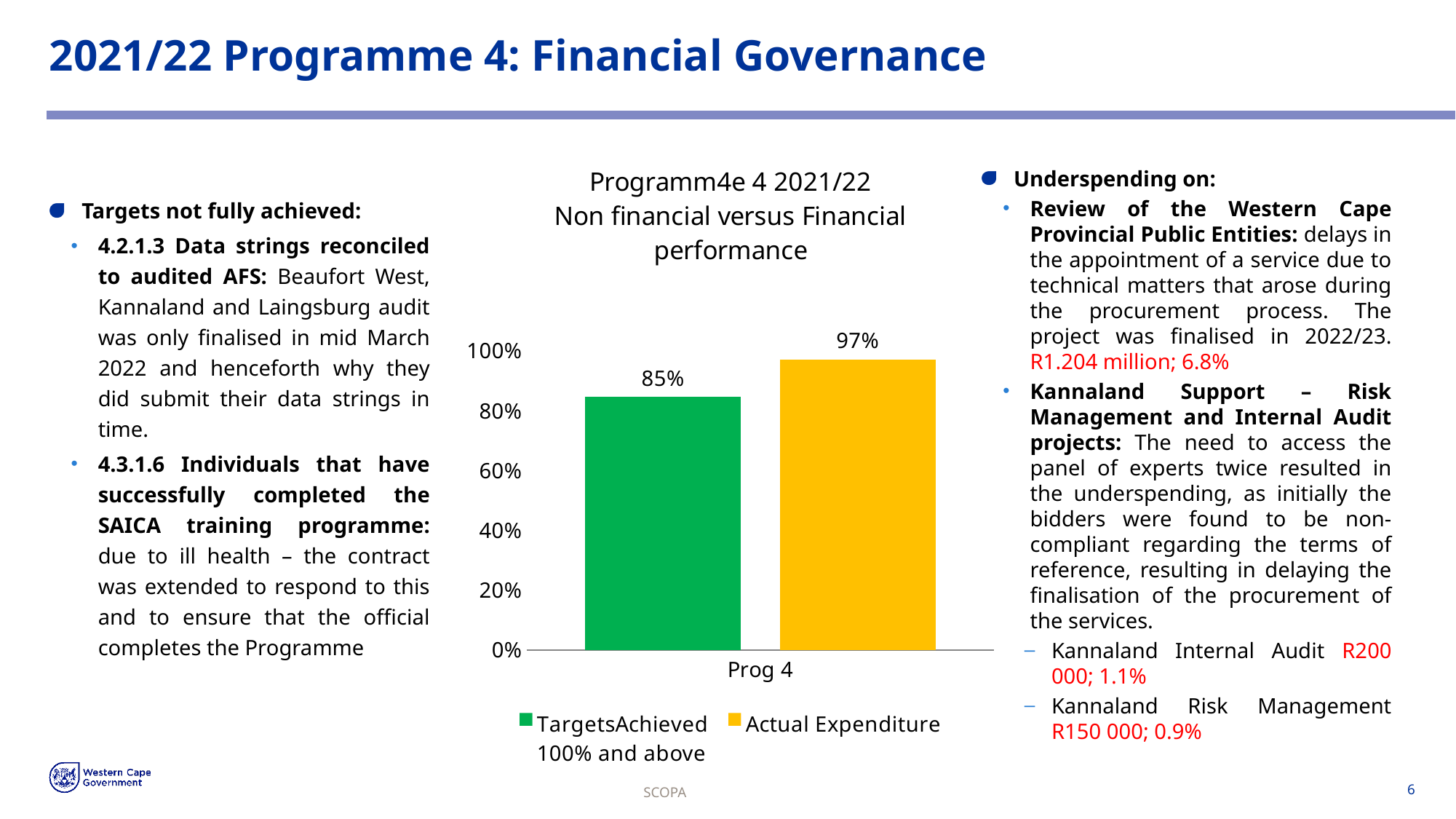
Which series has the lower value for Prog 4? Targets Achieved 100% and above What is the difference between Actual Expenditure and Targets Achieved 100% and above for Prog 4? 12% How many series does the chart legend list? 2 Which series has the higher value for Prog 4? Actual Expenditure What colour is the Actual Expenditure bar? yellow What kind of chart is shown on the slide? bar chart How many categories are shown on the x axis of the chart? 1 Is the value for Targets Achieved 100% and above greater or less than 80%? greater What is the value of Targets Achieved 100% and above for Prog 4? 85% What is the value of Actual Expenditure for Prog 4? 97% Is Actual Expenditure larger or smaller than Targets Achieved 100% and above for Prog 4? larger Is the value for Actual Expenditure greater or less than 100%? less